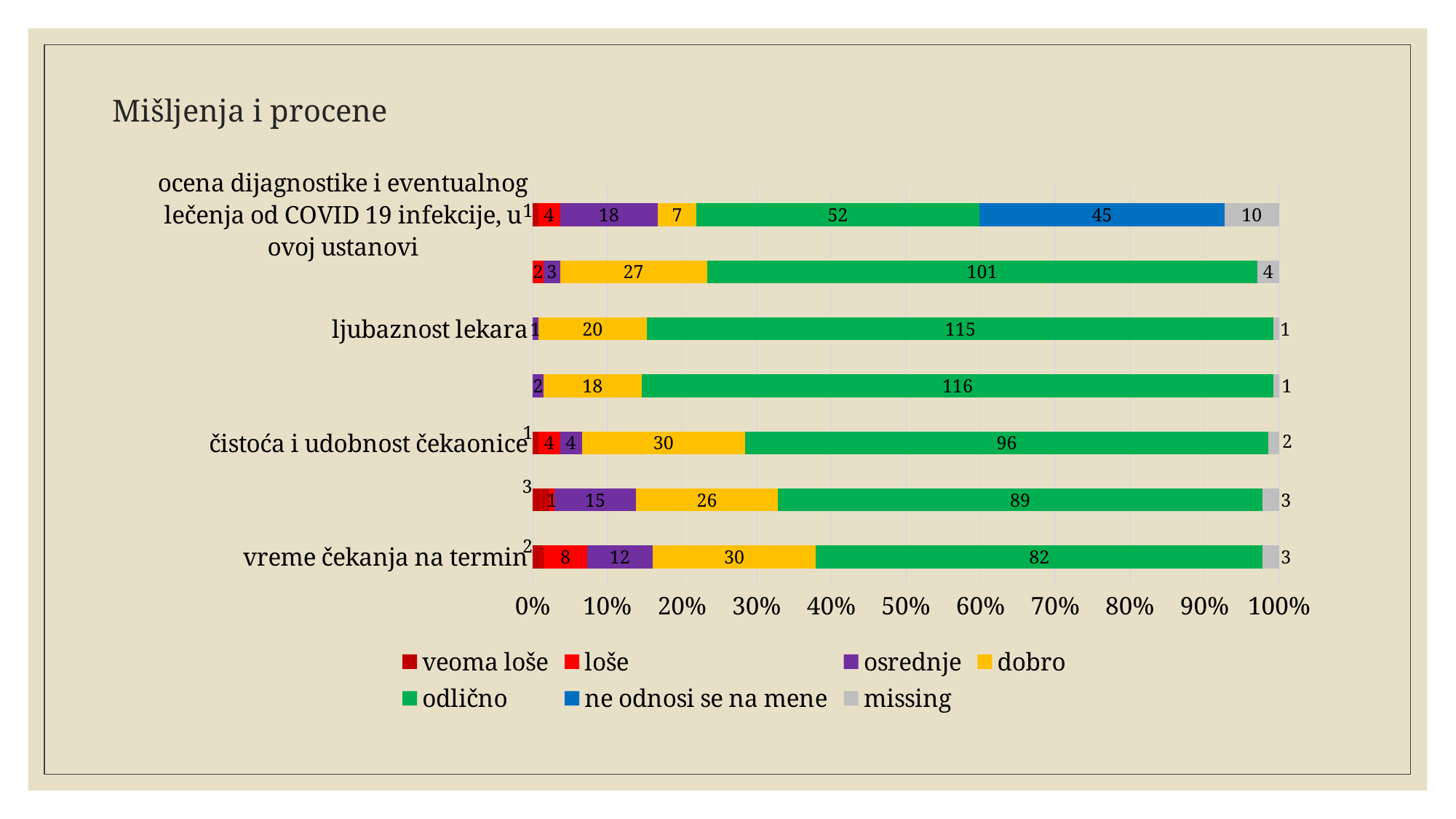
What is the total of all segments in the 'vreme čekanja na termin' bar? 137 Which has a larger 'osrednje' value: 'vreme čekanja na termin' or 'čistoća i udobnost čekaonice'? vreme čekanja na termin What kind of chart is shown on the slide? stacked bar chart How many series does the legend list? 7 What is the 'dobro' value for 'vreme čekanja na termin'? 30 How many bars are plotted in the chart? 7 What is the 'loše' value for 'čistoća i udobnost čekaonice'? 4 What is the difference between the 'odlično' values for 'čistoća i udobnost čekaonice' and 'vreme čekanja na termin'? 14 What is the 'odlično' value for 'ljubaznost lekara'? 115 What is the title of the slide? Mišljenja i procene What is the 'ne odnosi se na mene' value for 'ocena dijagnostike i eventualnog lečenja od COVID 19 infekcije, u ovoj ustanovi'? 45 What is the 'missing' value for 'ocena dijagnostike i eventualnog lečenja od COVID 19 infekcije, u ovoj ustanovi'? 10